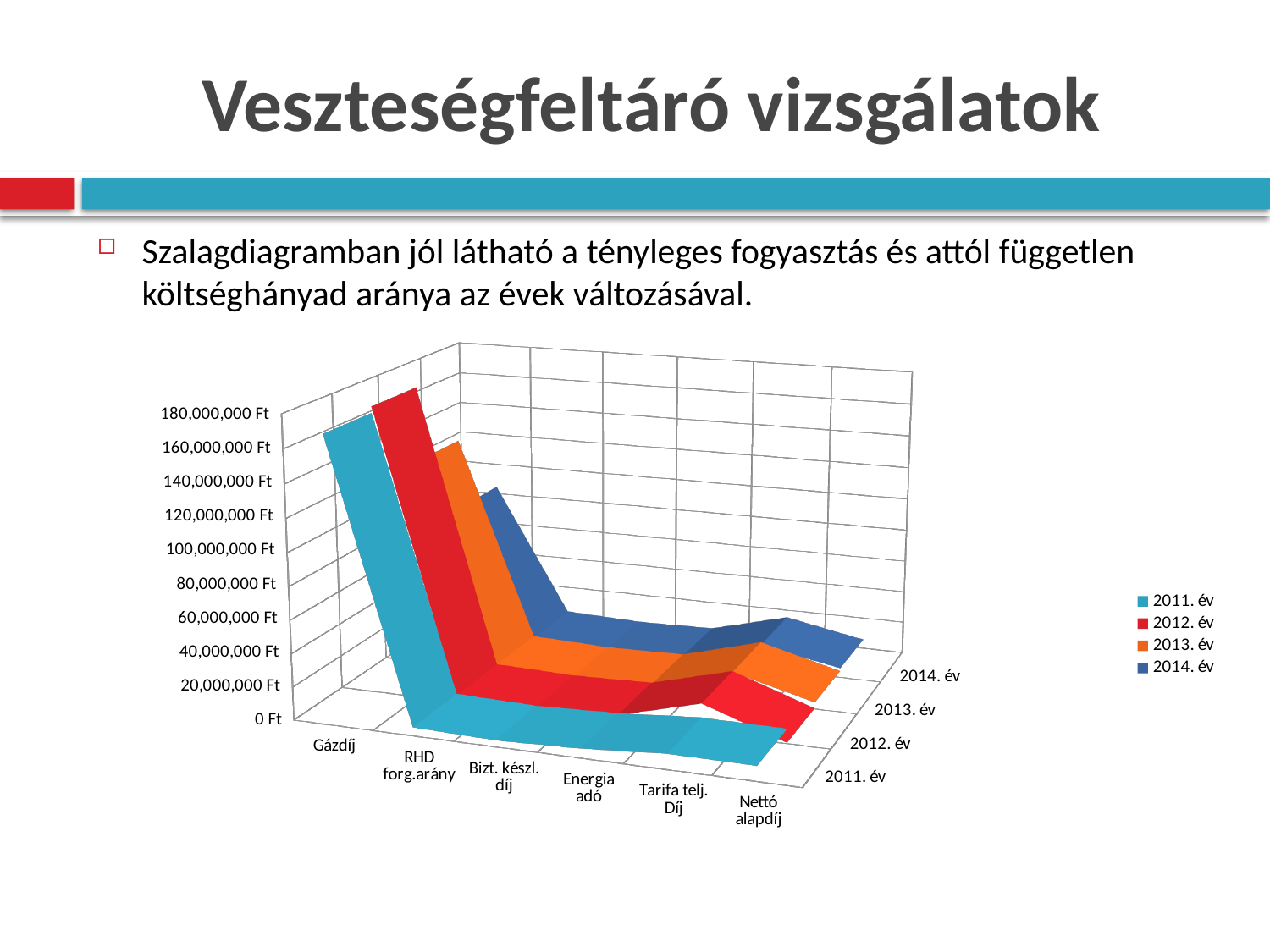
Do the values generally rise or fall moving from Gázdíj to Nettó alapdíj along the x axis? fall Which is larger for the 2012. év series: Gázdíj or Nettó alapdíj? Gázdíj Which series is drawn in red according to the legend? 2012. év Is the value for Energia adó in the 2011. év series greater or less than 60,000,000 Ft? less What kind of chart is shown on the slide? 3D ribbon (line) chart What is the first category label on the x axis? Gázdíj Which category has the highest value for the 2014. év series? Gázdíj How many categories are shown along the x axis of the chart? 6 What is the highest tick value shown on the vertical axis? 180,000,000 Ft How many series does the chart's legend list? 4 Is the value for Gázdíj in the 2011. év series greater or less than 100,000,000 Ft? greater Which category has the highest value for the 2011. év series? Gázdíj